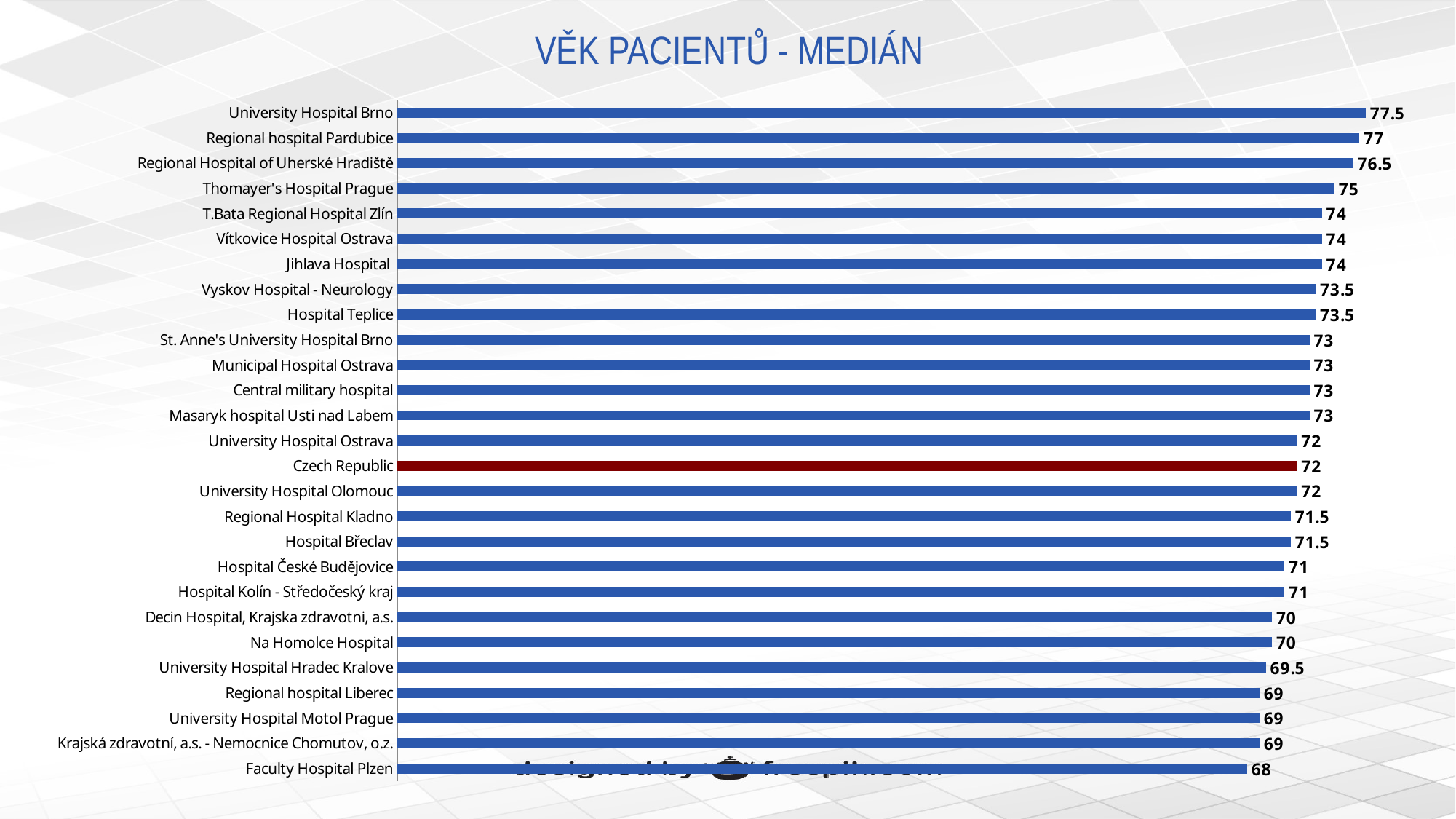
Which bar is shown in a different colour (dark red) from the others? Czech Republic What kind of chart is shown on the slide? Bar chart What is the difference between the median patient age for Thomayer's Hospital Prague and Czech Republic? 3 What is the median patient age for Czech Republic? 72 Which has a higher median patient age, Regional hospital Pardubice or Hospital Teplice? Regional hospital Pardubice What is the median patient age for University Hospital Brno? 77.5 What is the difference between the median patient age for University Hospital Brno and Faculty Hospital Plzen? 9.5 What is the median patient age for Faculty Hospital Plzen? 68 Which category has the highest median patient age? University Hospital Brno How many categories are shown in the chart? 27 What is the median patient age for University Hospital Hradec Kralove? 69.5 Which category has the lowest median patient age? Faculty Hospital Plzen